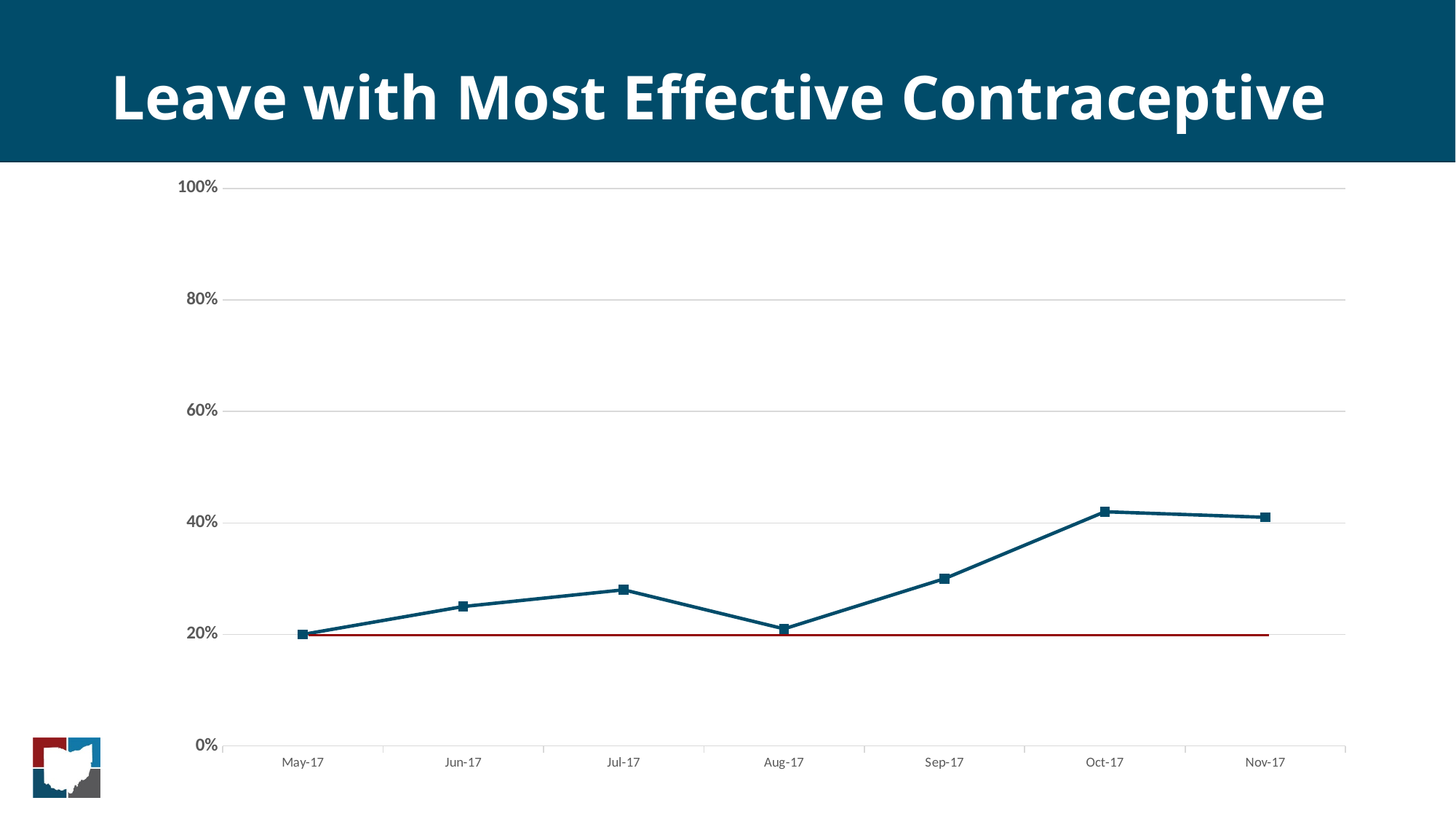
Do the values rise or fall from Aug-17 to Oct-17? rise Is the value for Jun-17 greater or less than 40%? less What kind of chart is shown on the slide? line chart What is the title of the chart on the slide? Leave with Most Effective Contraceptive Is the value for Sep-17 greater or less than 20%? greater What is the value for May-17? 20% At what level is the horizontal red reference line drawn? 20% Which is higher, the value for Jul-17 or the value for Aug-17? Jul-17 Is the value for Jul-17 greater or less than 40%? less Which is higher, the value for Sep-17 or the value for Jun-17? Sep-17 How many months are plotted along the x axis? 7